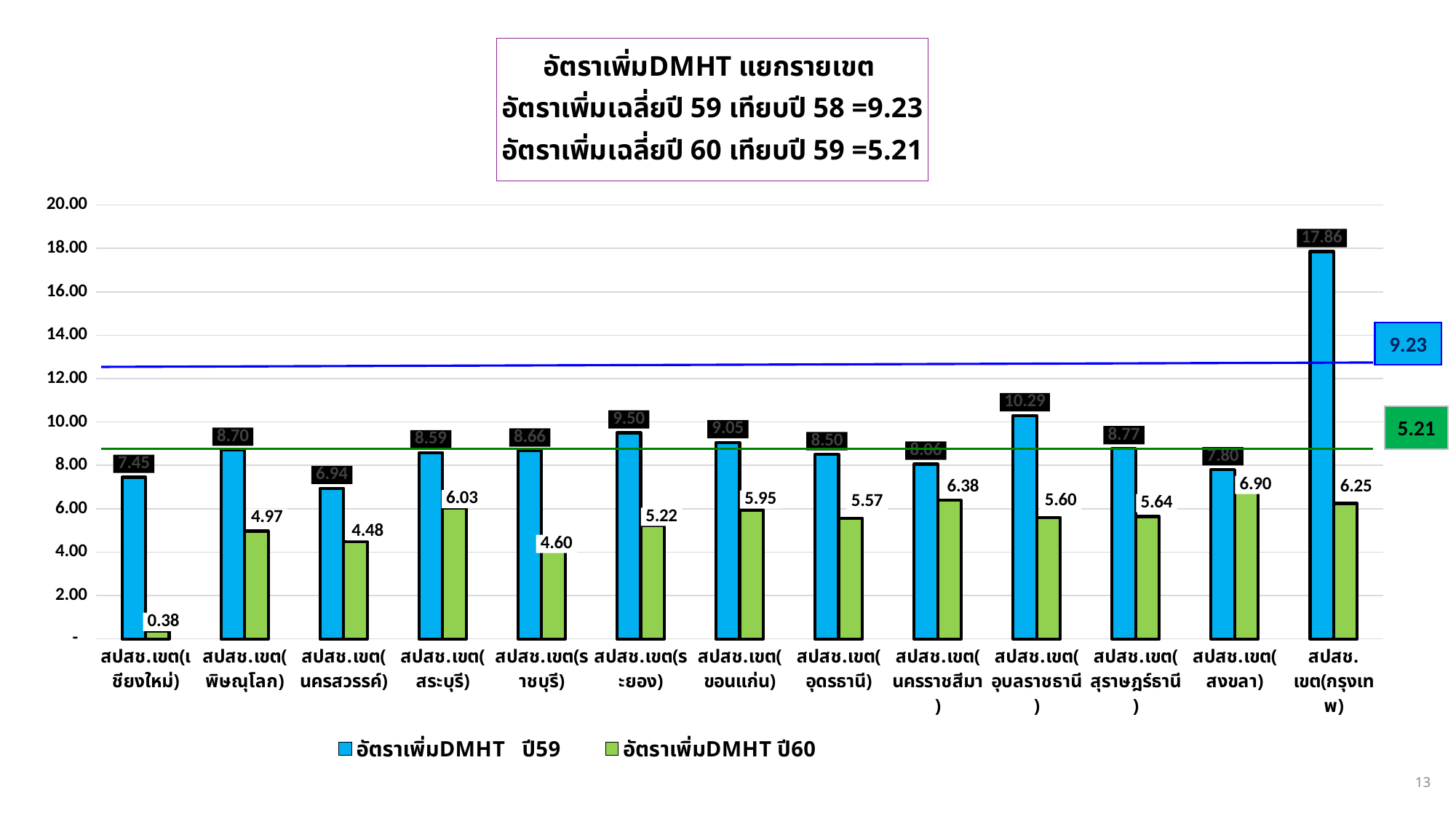
What is the difference between the อัตราเพิ่มDMHT ปี59 and ปี60 values for สปสช.เขต(ระยอง)? 4.28 What is the อัตราเพิ่มDMHT ปี59 value for สปสช.เขต(กรุงเทพ)? 17.86 Is the อัตราเพิ่มDMHT ปี59 value for สปสช.เขต(กรุงเทพ) greater or less than 16.00? greater How many series does the legend list? 2 How many regions (categories) are shown on the x axis? 13 Which region has the highest อัตราเพิ่มDMHT ปี60 value? สปสช.เขต(สงขลา) What is the อัตราเพิ่มDMHT ปี59 value for สปสช.เขต(อุบลราชธานี)? 10.29 Which region has the lowest อัตราเพิ่มDMHT ปี59 value? สปสช.เขต(นครสวรรค์) What kind of chart is shown on the slide? bar chart Which is larger: the อัตราเพิ่มDMHT ปี60 value for สปสช.เขต(สระบุรี) or for สปสช.เขต(ราชบุรี)? สปสช.เขต(สระบุรี) What is the อัตราเพิ่มDMHT ปี60 value for สปสช.เขต(เชียงใหม่)? 0.38 What value is shown in the blue box at the right of the chart? 9.23